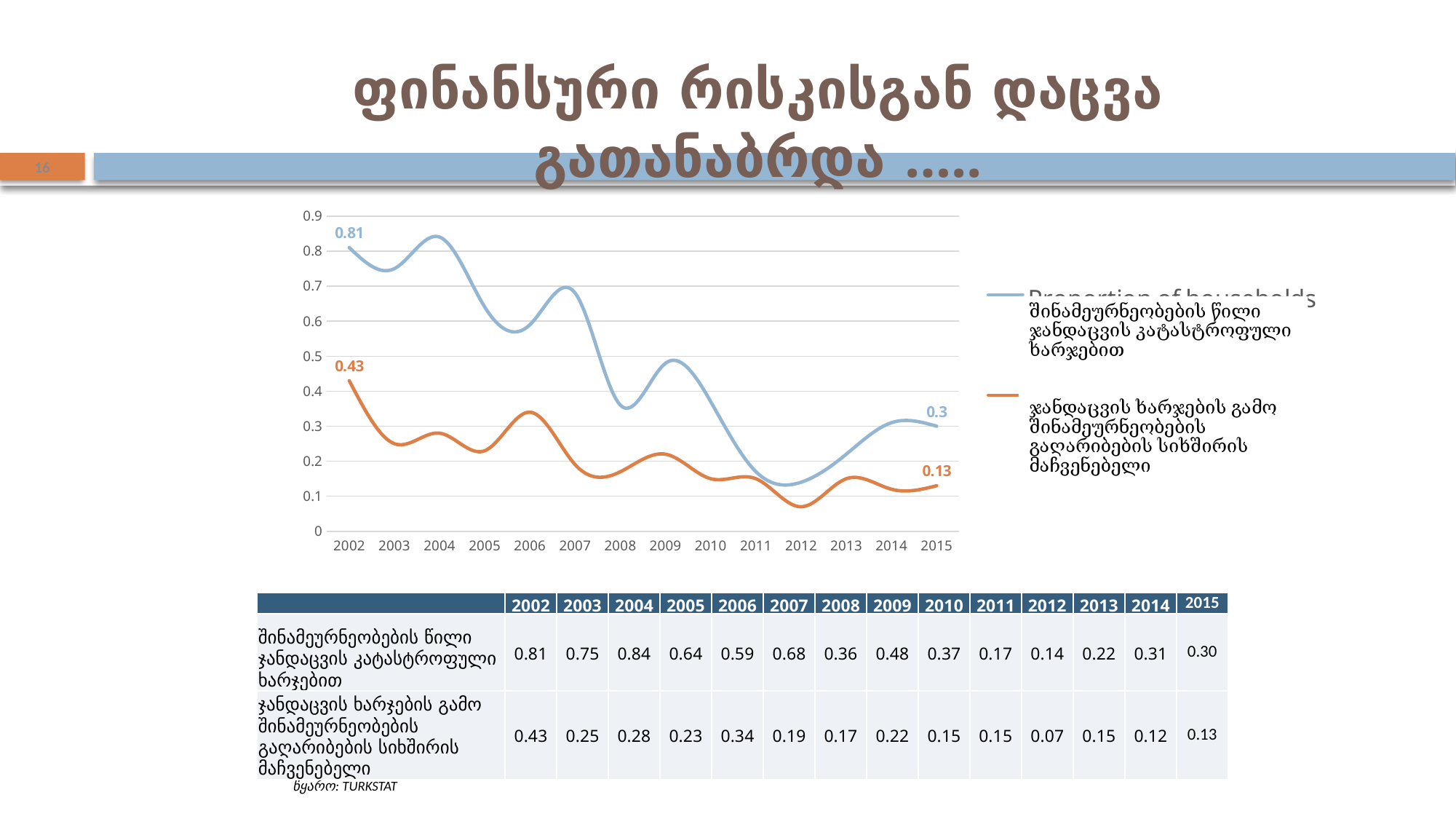
What type of chart is shown on the slide? line chart In which year does the orange line (ჯანდაცვის ხარჯების გამო შინამეურნეობების გაღარიბების სიხშირის მაჩვენებელი) reach its lowest value? 2012 Overall, does the blue line rise or fall from 2002 to 2015? fall In which year does the blue line (შინამეურნეობების წილი ჯანდაცვის კატასტროფული ხარჯებით) reach its highest value? 2004 What value does the blue line reach in 2015? 0.3 What value does the orange line reach in 2015? 0.13 What is the value of the blue line (შინამეურნეობების წილი ჯანდაცვის კატასტროფული ხარჯებით) in 2002? 0.81 What is the difference between the blue line's value in 2002 and its value in 2015? 0.51 How many years are plotted along the x axis of the chart? 14 Which series has the higher value in 2009, the blue line or the orange line? the blue line What is the value of the orange line (ჯანდაცვის ხარჯების გამო შინამეურნეობების გაღარიბების სიხშირის მაჩვენებელი) in 2002? 0.43 How many series does the chart's legend list? 2